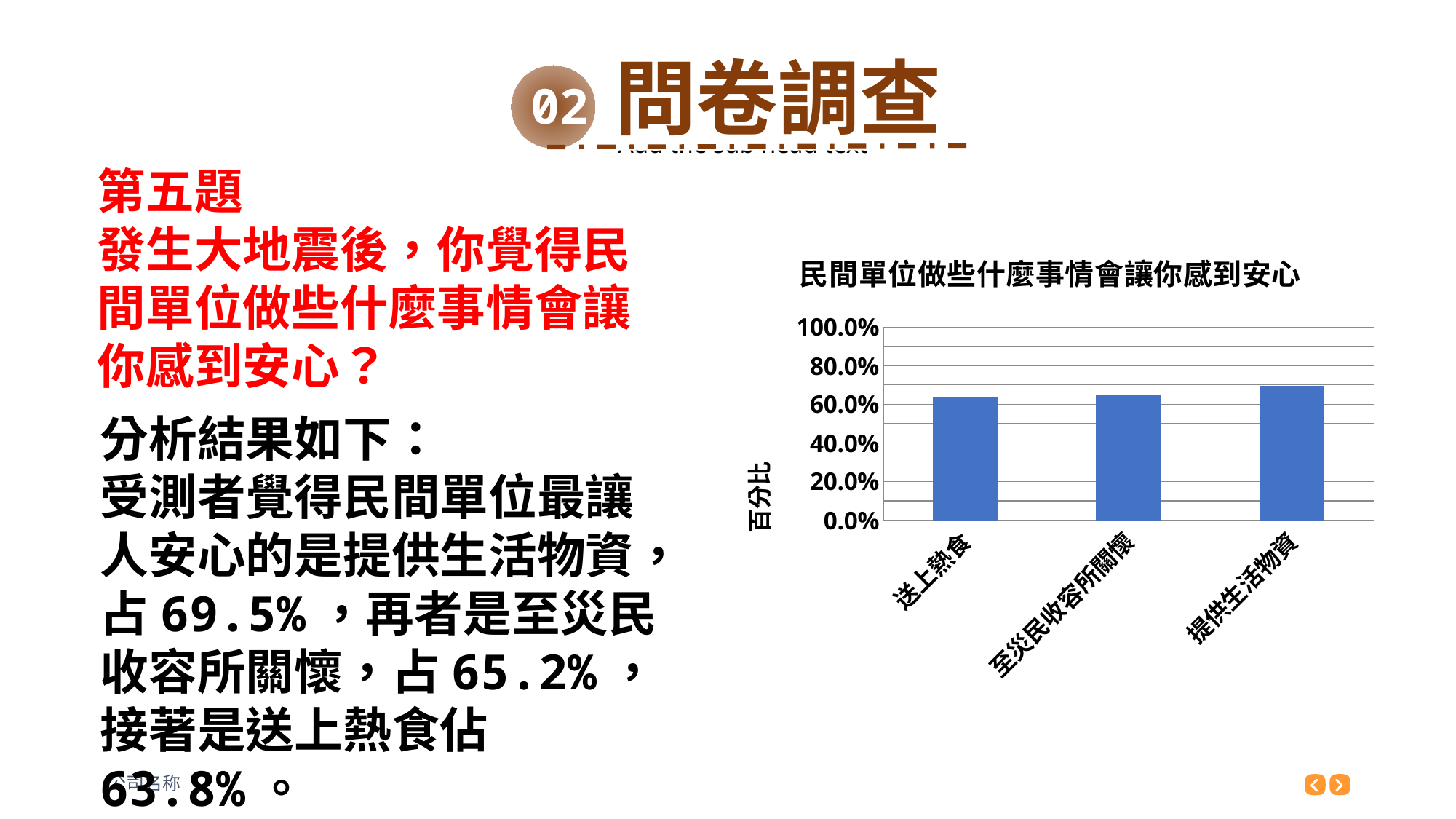
What kind of chart is shown on the slide? bar chart Which category has the lowest bar in the chart? 送上熱食 What is the label of the vertical axis of the chart? 百分比 What is the title of the chart? 民間單位做些什麼事情會讓你感到安心 Is the value for 至災民收容所關懷 greater or less than 40.0%? greater Which is larger, the value for 提供生活物資 or the value for 送上熱食? 提供生活物資 How many categories are plotted on the x axis of the chart? 3 Is the value for 提供生活物資 greater or less than 80.0%? less Which category has the highest bar in the chart? 提供生活物資 Is the value for 送上熱食 greater or less than 60.0%? greater Do the bar values rise or fall from left to right along the x axis? rise According to the slide, what percentage is shown for 提供生活物資? 69.5%